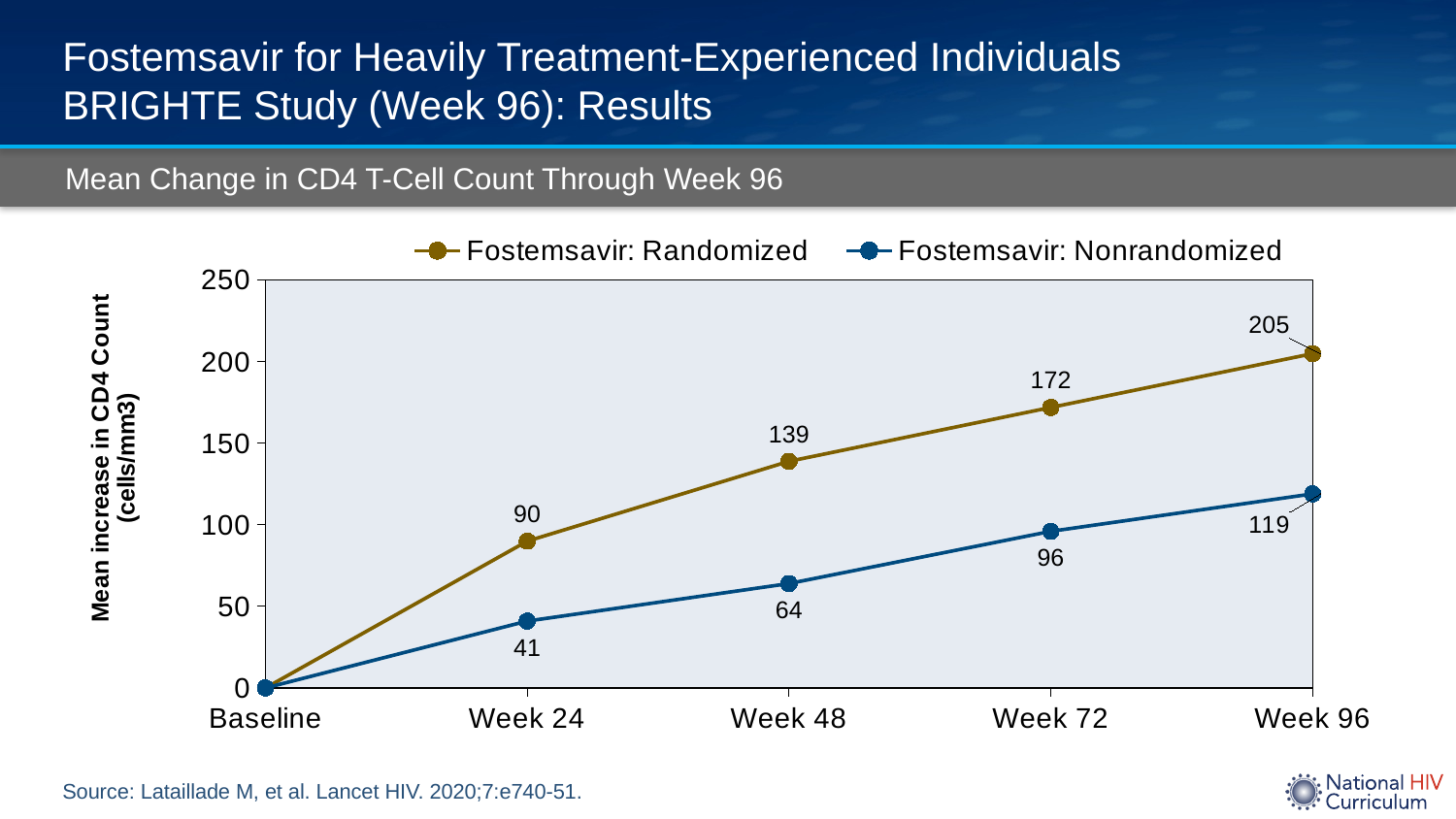
How many time points are shown on the x axis? 5 What kind of chart is shown on the slide? Line chart What is the difference between the Randomized and Nonrandomized values at Week 96? 86 How many series does the legend list? 2 What is the value for Fostemsavir: Nonrandomized at Week 72? 96 What is the value for Fostemsavir: Randomized at Week 24? 90 Which series has the larger value at Week 72, Randomized or Nonrandomized? Fostemsavir: Randomized At which time point does the Fostemsavir: Randomized series reach its highest value? Week 96 Is the Fostemsavir: Nonrandomized value at Week 24 greater or less than 50? less What is the mean increase in CD4 count for Fostemsavir: Nonrandomized at Week 48? 64 What is the mean increase in CD4 count for Fostemsavir: Randomized at Week 96? 205 What is the difference between the Randomized values at Week 48 and Week 24? 49